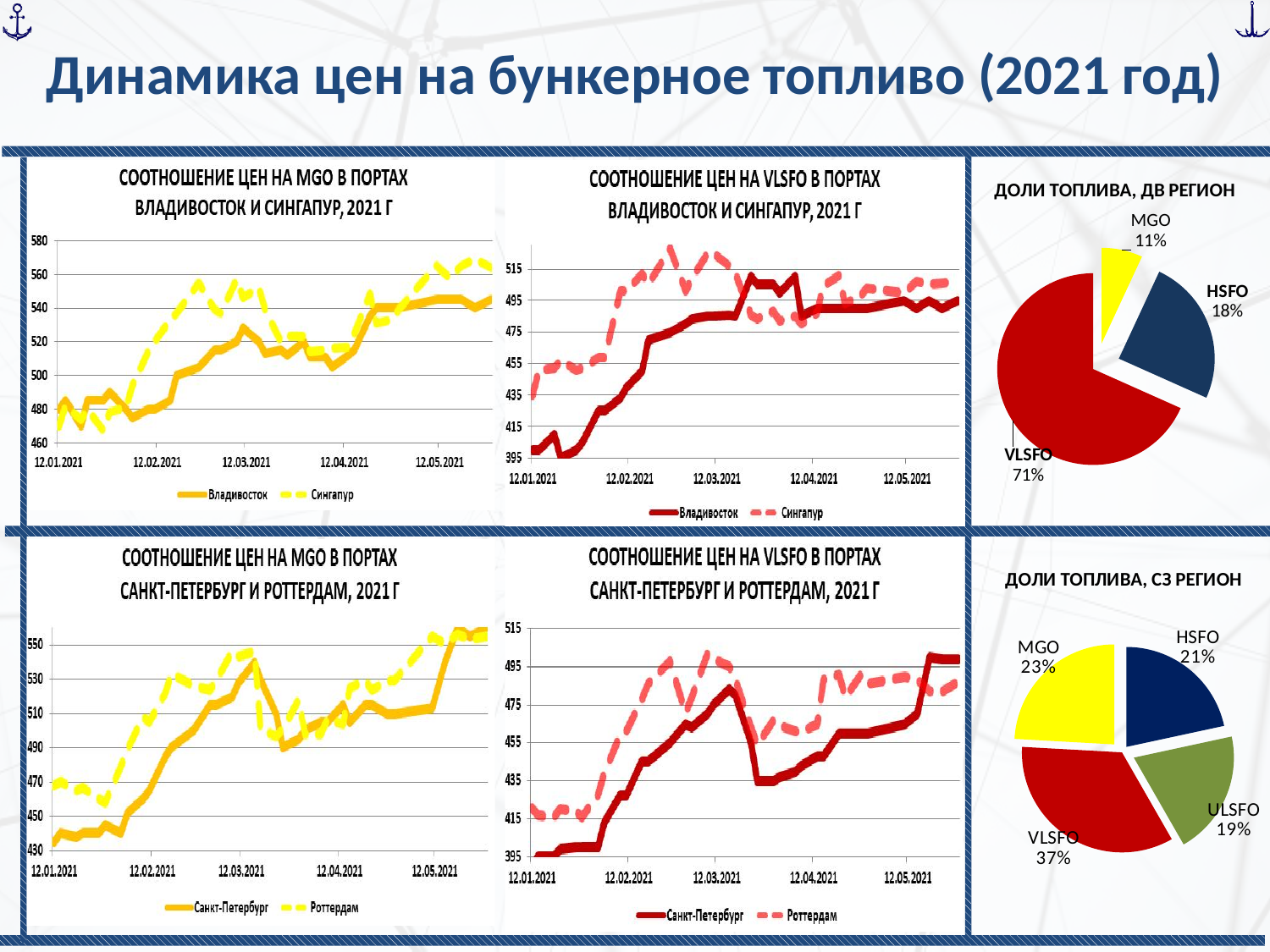
In the chart 'СООТНОШЕНИЕ ЦЕН НА VLSFO В ПОРТАХ ВЛАДИВОСТОК И СИНГАПУР, 2021 Г', is the value for Владивосток at 12.01.2021 greater or less than 415? less In the chart 'СООТНОШЕНИЕ ЦЕН НА MGO В ПОРТАХ САНКТ-ПЕТЕРБУРГ И РОТТЕРДАМ, 2021 Г', is the value for Санкт-Петербург at 12.01.2021 greater or less than 450? less In the pie chart 'ДОЛИ ТОПЛИВА, СЗ РЕГИОН', how many slices are there? 4 What kind of chart is 'СООТНОШЕНИЕ ЦЕН НА MGO В ПОРТАХ ВЛАДИВОСТОК И СИНГАПУР, 2021 Г'? Line chart In the pie chart 'ДОЛИ ТОПЛИВА, СЗ РЕГИОН', which is larger, the MGO share or the HSFO share? MGO How many series does the legend of 'СООТНОШЕНИЕ ЦЕН НА VLSFO В ПОРТАХ САНКТ-ПЕТЕРБУРГ И РОТТЕРДАМ, 2021 Г' list? 2 In the pie chart 'ДОЛИ ТОПЛИВА, СЗ РЕГИОН', what share does ULSFO have? 19% In the chart 'СООТНОШЕНИЕ ЦЕН НА MGO В ПОРТАХ ВЛАДИВОСТОК И СИНГАПУР, 2021 Г', do the Владивосток prices overall rise or fall from 12.01.2021 to 12.05.2021? Rise In the pie chart 'ДОЛИ ТОПЛИВА, ДВ РЕГИОН', what share does VLSFO have? 71% In the pie chart 'ДОЛИ ТОПЛИВА, СЗ РЕГИОН', which fuel has the largest share? VLSFO In the pie chart 'ДОЛИ ТОПЛИВА, ДВ РЕГИОН', what is the difference between the HSFO share and the MGO share? 7% In the pie chart 'ДОЛИ ТОПЛИВА, ДВ РЕГИОН', which fuel has the smallest share? MGO